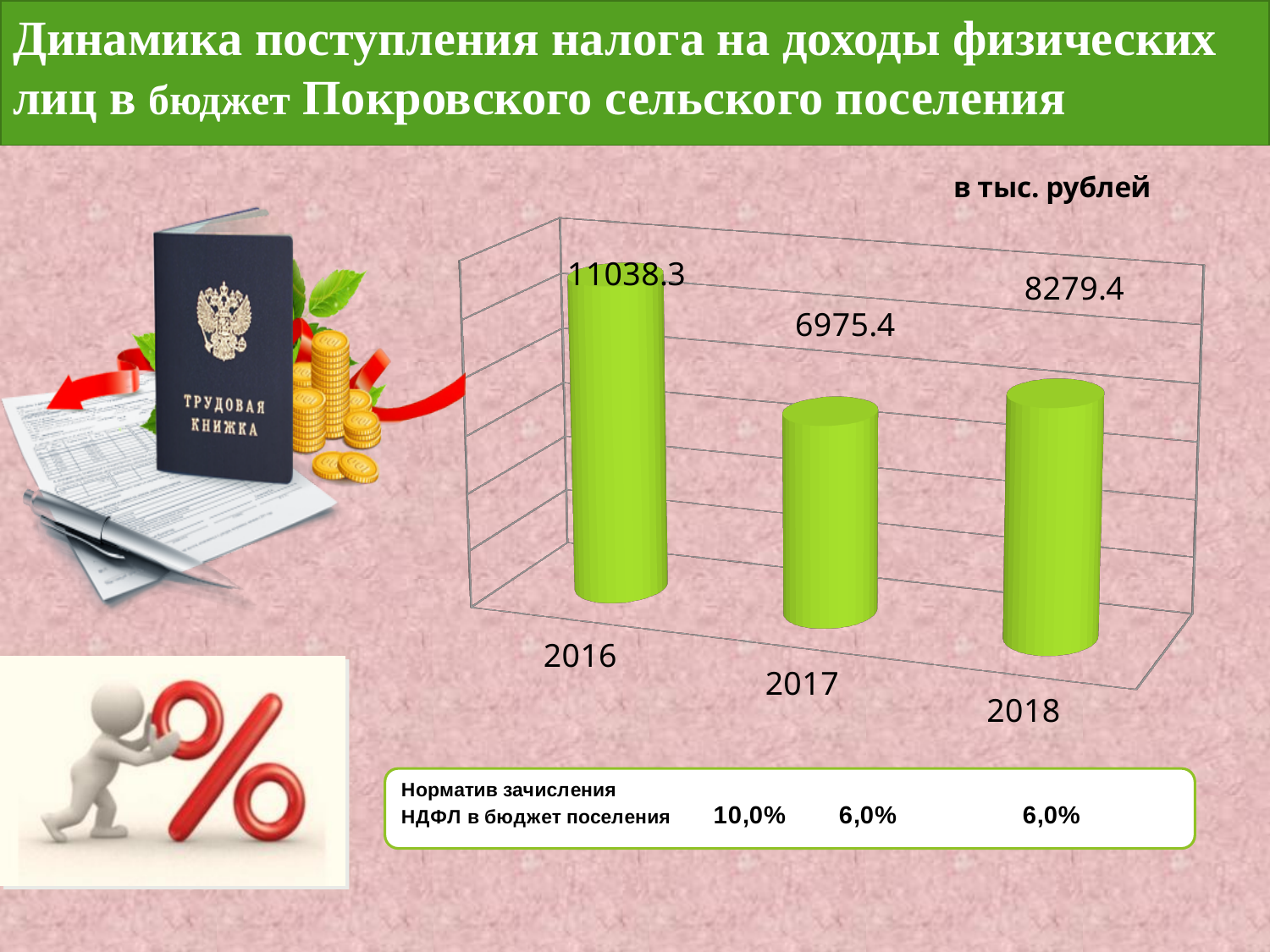
Which is larger, the value for 2017 or the value for 2018? 2018 What kind of chart is shown on the slide? bar chart What is the value for 2016? 11038.3 What is the difference between the values for 2018 and 2017? 1304.0 Does the value rise or fall from 2016 to 2017? fall What is the value for 2017? 6975.4 What is the difference between the values for 2016 and 2017? 4062.9 How many years are shown on the chart? 3 In what units are the chart values given, according to the label above the chart? в тыс. рублей Which year has the highest value? 2016 What is the value for 2018? 8279.4 Which year has the lowest value? 2017